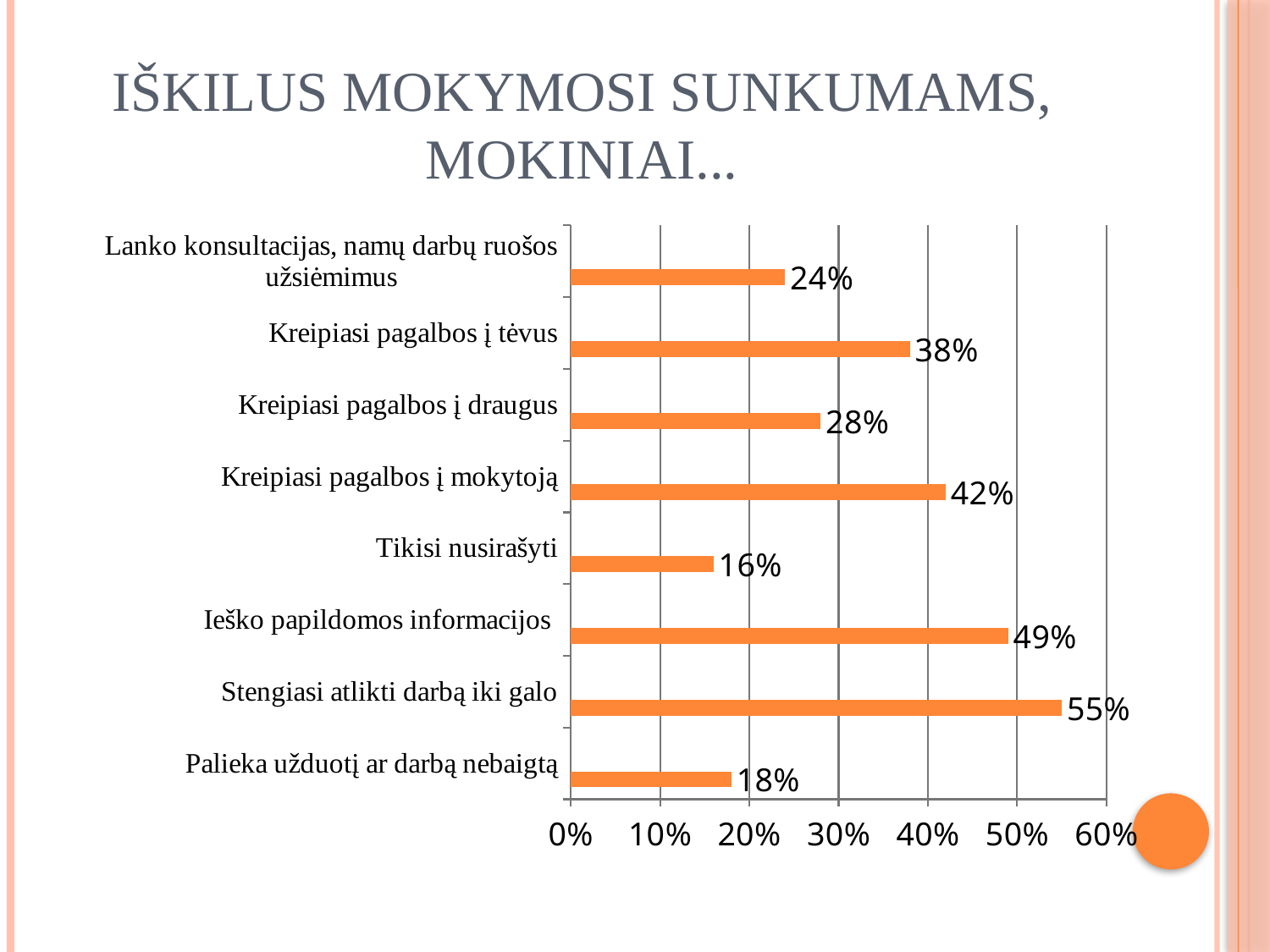
What is the value for "Lanko konsultacijas, namų darbų ruošos užsiėmimus"? 24% What kind of chart is shown on the slide? bar chart What is the value for "Stengiasi atlikti darbą iki galo"? 55% Which category has the highest value? Stengiasi atlikti darbą iki galo What is the highest value shown on the x axis? 60% Is the value for "Ieško papildomos informacijos" greater or less than 40%? greater Which is larger: the value for "Kreipiasi pagalbos į mokytoją" or the value for "Kreipiasi pagalbos į draugus"? Kreipiasi pagalbos į mokytoją Which category has the lowest value? Tikisi nusirašyti How many categories are shown in the chart? 8 What is the value for "Kreipiasi pagalbos į tėvus"? 38% What is the value for "Tikisi nusirašyti"? 16% What is the difference between the values for "Ieško papildomos informacijos" and "Palieka užduotį ar darbą nebaigtą"? 31%